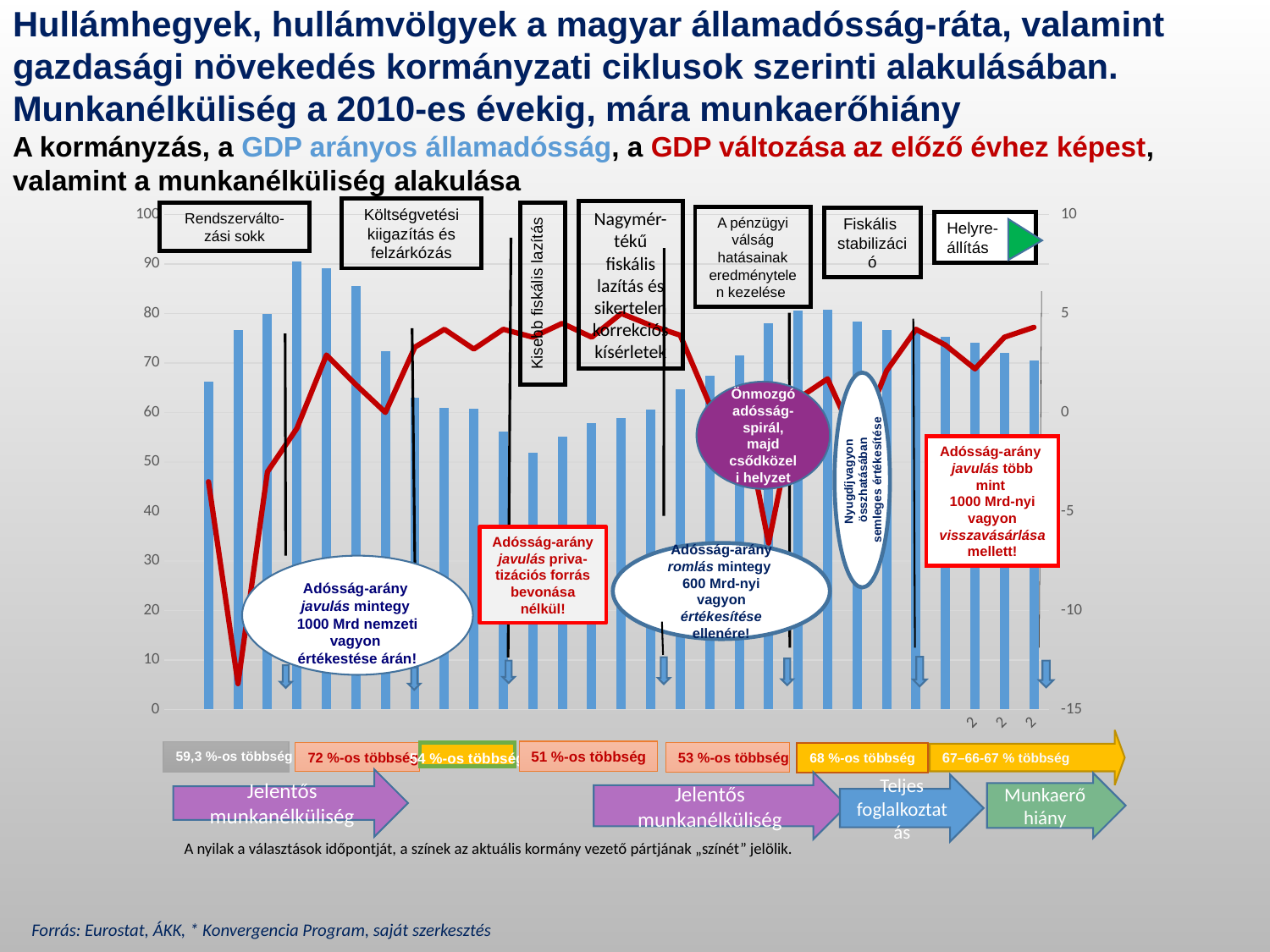
Which colour represents the GDP-proportional government debt (GDP arányos államadósság) in the chart? blue Is the value of the shortest blue bar greater or less than 60 on the left axis? less Is the lowest point of the red line greater or less than -10 on the right axis? less What source is cited for the chart at the bottom of the slide? Eurostat, ÁKK, * Konvergencia Program, saját szerkesztés Is the value of the rightmost blue bar greater or less than 60 on the left axis? greater Does the red line rise or fall between its first and second points at the left of the chart? fall What kind of chart is shown on the slide? bar and line chart